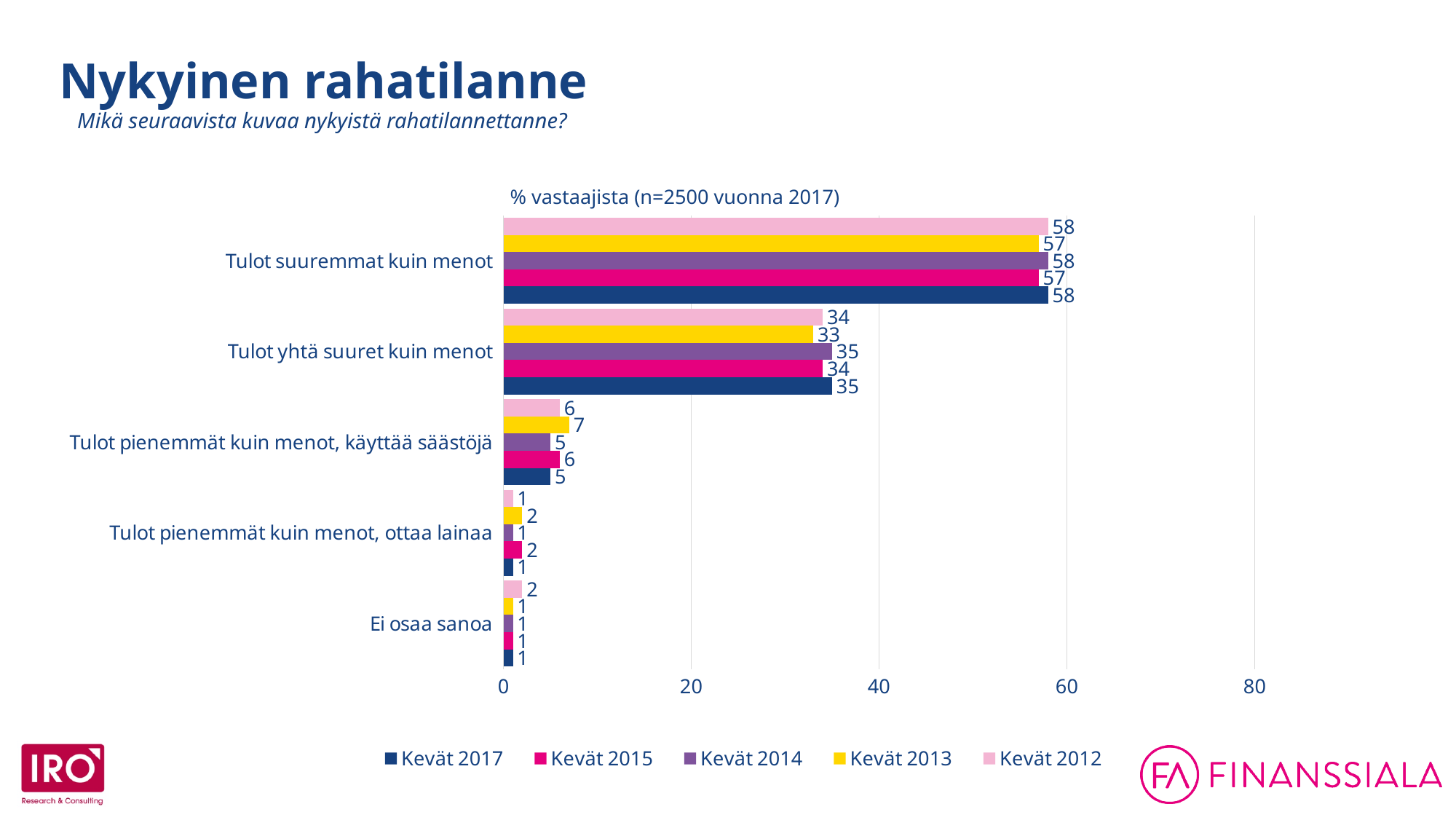
Which category has the highest value in the Kevät 2017 series? Tulot suuremmat kuin menot What is the value for "Tulot yhtä suuret kuin menot" in the Kevät 2013 series? 33 What is the value for "Tulot pienemmät kuin menot, käyttää säästöjä" in the Kevät 2013 series? 7 How many series does the legend list? 5 What is the value for "Tulot suuremmat kuin menot" in the Kevät 2017 series? 58 What kind of chart is shown on the slide? Bar chart What is the value for "Ei osaa sanoa" in the Kevät 2012 series? 2 Is the Kevät 2015 value for "Tulot suuremmat kuin menot" greater or less than 40? greater For "Tulot pienemmät kuin menot, käyttää säästöjä", which is larger: the Kevät 2013 value or the Kevät 2017 value? Kevät 2013 How many categories are shown on the chart? 5 What is the difference between the Kevät 2017 values for "Tulot suuremmat kuin menot" and "Tulot yhtä suuret kuin menot"? 23 Which category has the lowest value in the Kevät 2013 series? Ei osaa sanoa